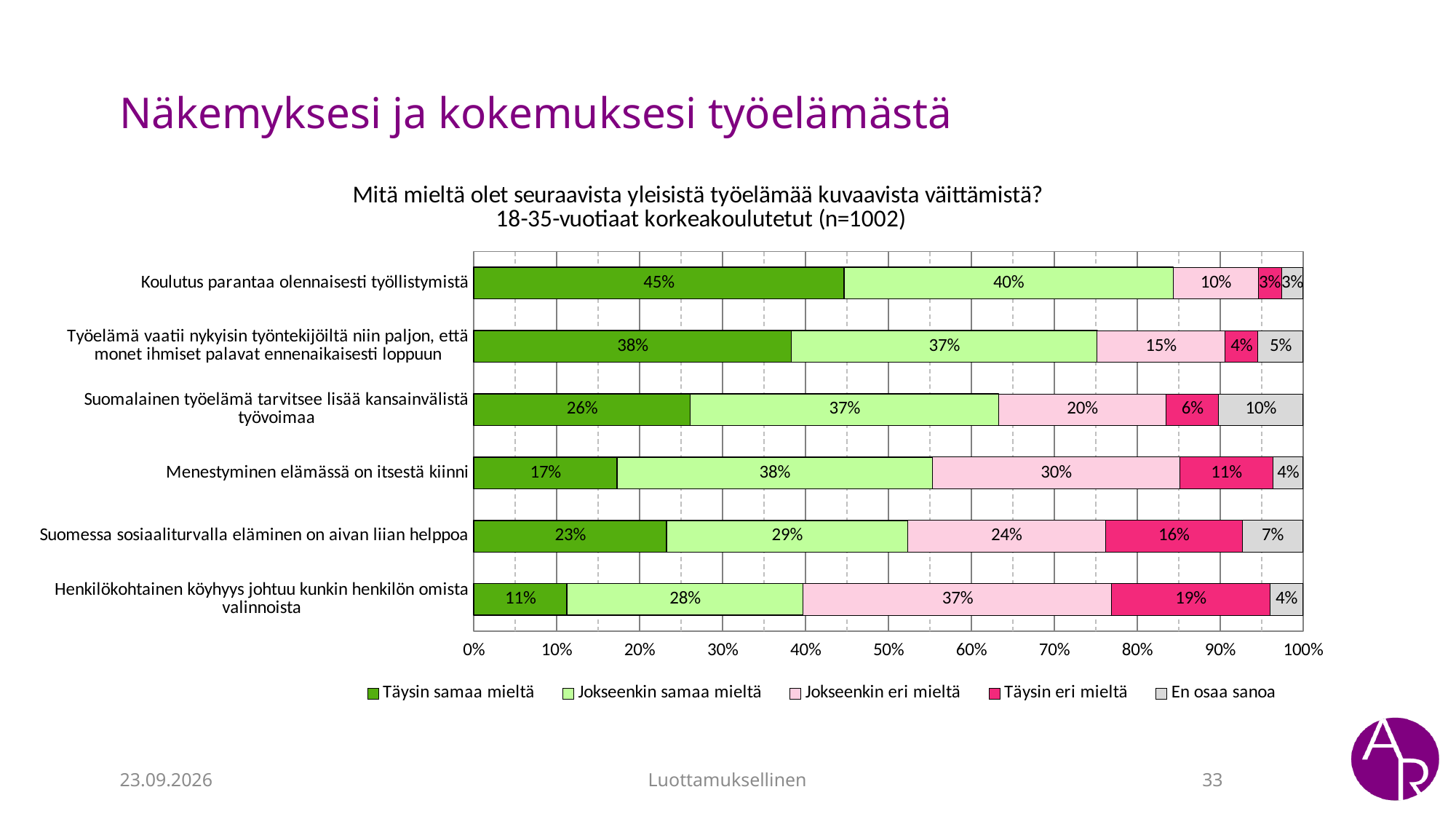
What is the sample size (n) stated in the chart title? 1002 Which statement has the lowest 'Täysin samaa mieltä' share? Henkilökohtainen köyhyys johtuu kunkin henkilön omista valinnoista Which is larger: the 'Täysin eri mieltä' value for 'Suomessa sosiaaliturvalla eläminen on aivan liian helppoa' or for 'Menestyminen elämässä on itsestä kiinni'? Suomessa sosiaaliturvalla eläminen on aivan liian helppoa Which statement has the highest 'Täysin samaa mieltä' share? Koulutus parantaa olennaisesti työllistymistä What is the total of the stacked bar for 'Menestyminen elämässä on itsestä kiinni'? 100% How many series does the legend list? 5 What kind of chart is shown on the slide? Stacked bar chart What is the difference between the 'Jokseenkin eri mieltä' values for 'Menestyminen elämässä on itsestä kiinni' and 'Koulutus parantaa olennaisesti työllistymistä'? 20% What is the 'Täysin samaa mieltä' value for 'Koulutus parantaa olennaisesti työllistymistä'? 45% How many statements (categories) are plotted in the chart? 6 What is the 'En osaa sanoa' value for 'Suomalainen työelämä tarvitsee lisää kansainvälistä työvoimaa'? 10% What is the 'Täysin eri mieltä' value for 'Henkilökohtainen köyhyys johtuu kunkin henkilön omista valinnoista'? 19%